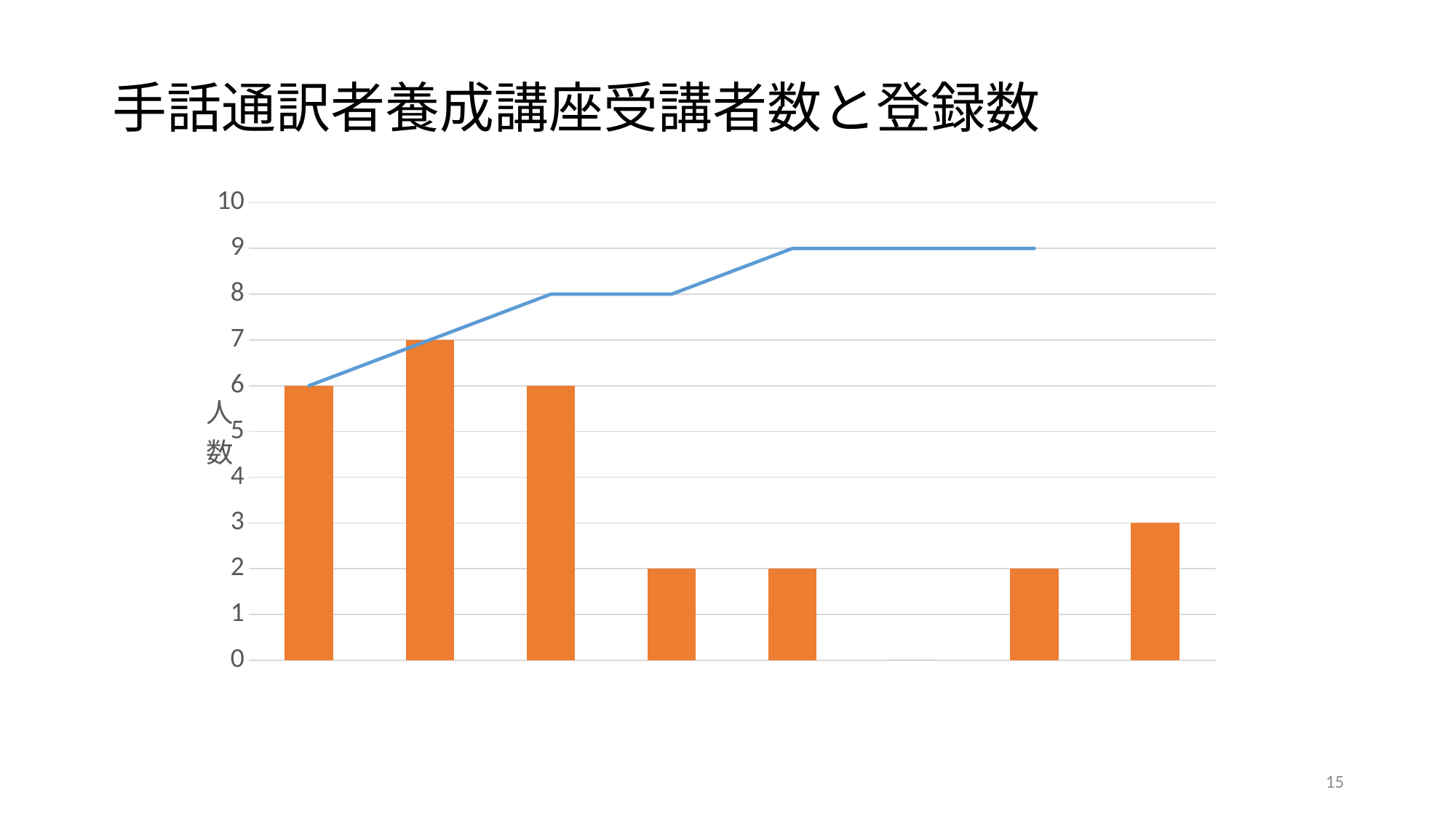
What is the value of the rightmost orange bar? 3 What kind of chart is shown on the slide? bar chart with a line What is the value of the second orange bar from the left? 7 What is the label on the vertical axis? 人数 What is the highest value reached by the blue line? 9 Which orange bar is the tallest? the second bar from the left What is the title of the chart? 手話通訳者養成講座受講者数と登録数 What is the difference between the second orange bar and the first orange bar? 1 What is the value of the first (leftmost) orange bar? 6 Which is larger, the third orange bar or the fourth orange bar from the left? the third bar Is the value of the rightmost orange bar greater or less than 5? less Does the blue line rise or fall from left to right? rises